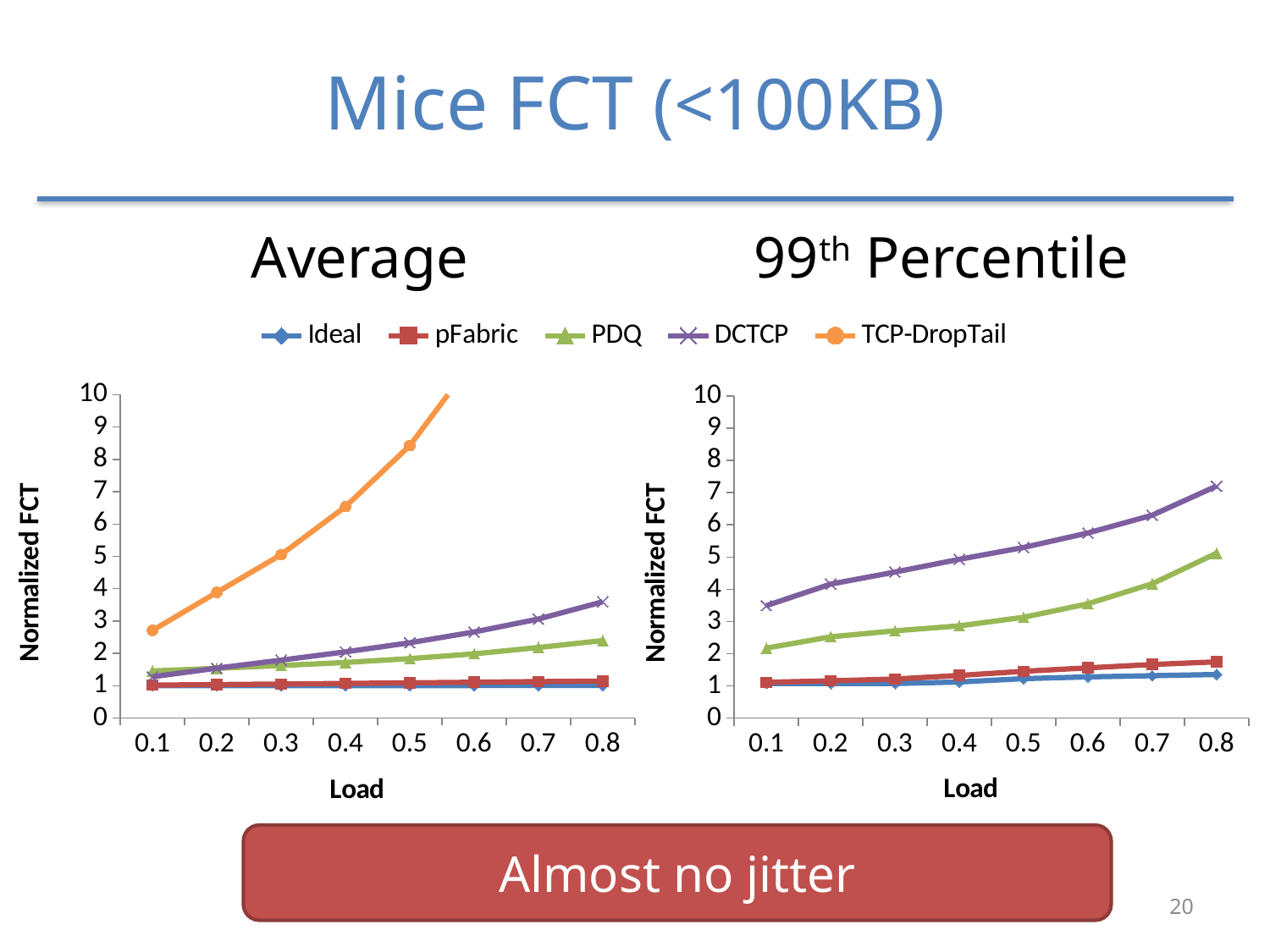
In the Average chart, how many load values are plotted along the x axis? 8 How many series does the legend list? 5 In the 99th Percentile chart, does the DCTCP series rise or fall as load increases from 0.1 to 0.8? rise In the Average chart, is the value for TCP-DropTail at load 0.4 greater or less than 6? greater In the Average chart, which series has the highest normalized FCT at load 0.5? TCP-DropTail In the Average chart, is the value for DCTCP at load 0.8 greater or less than 3? greater In the 99th Percentile chart, which series has the highest normalized FCT at load 0.8? DCTCP In the 99th Percentile chart, is the value for DCTCP at load 0.8 greater or less than 6? greater What is the label of the y axis on the 99th Percentile chart? Normalized FCT In the 99th Percentile chart, which series has the lowest normalized FCT at load 0.8? Ideal What type of chart is the Average chart? line chart